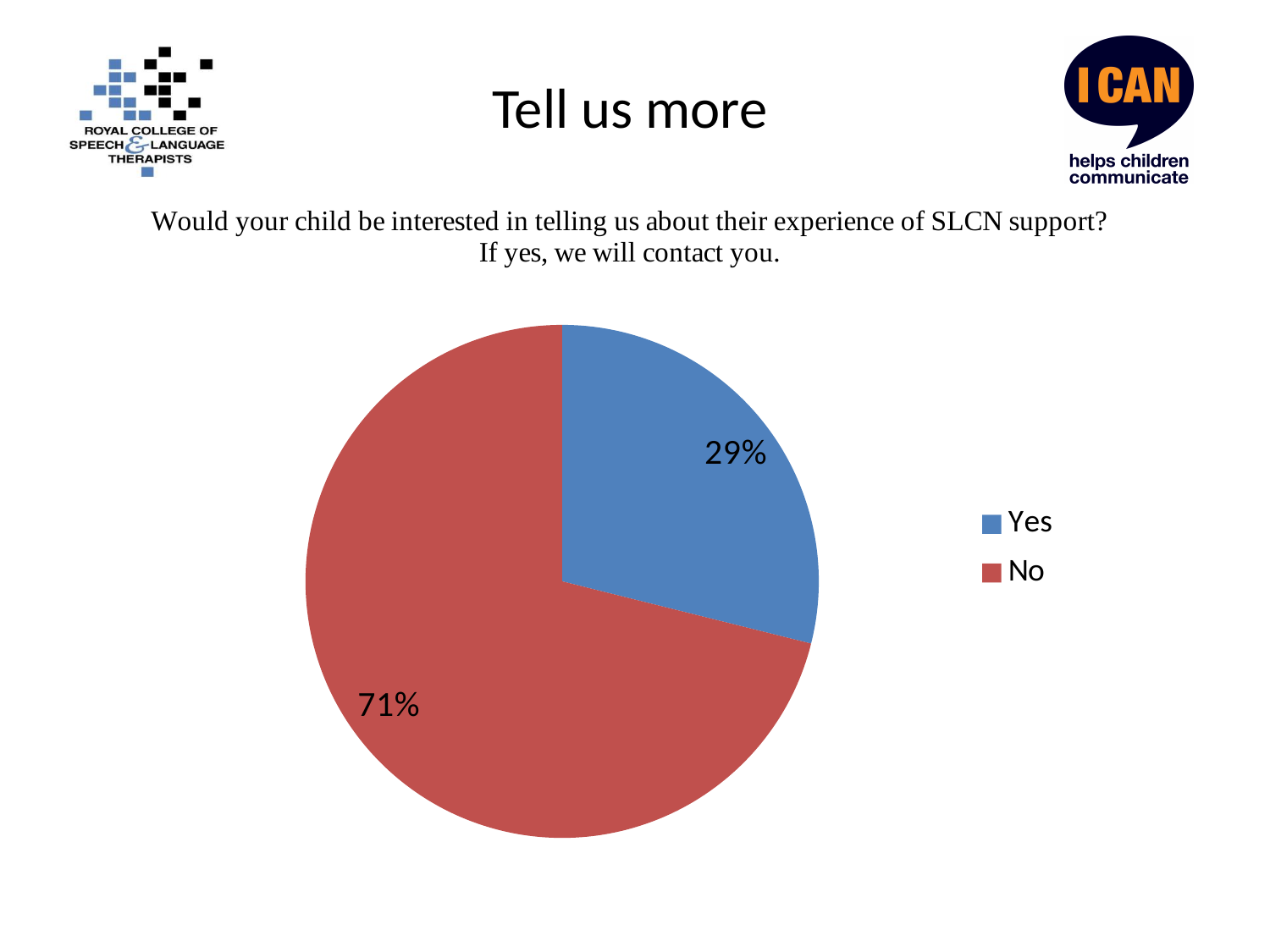
What percentage of respondents answered No? 71% What percentage of respondents answered Yes? 29% Which response has the largest share of the pie? No How many slices does the pie chart have? 2 How many entries does the legend list? 2 What colour is the No slice? red What share of the pie does the Yes slice represent? 29% What is the difference in percentage points between the No and Yes slices? 42 Which response has the smallest share of the pie? Yes What colour is the Yes slice? blue Which slice is larger, Yes or No? No What kind of chart is shown on the slide? pie chart